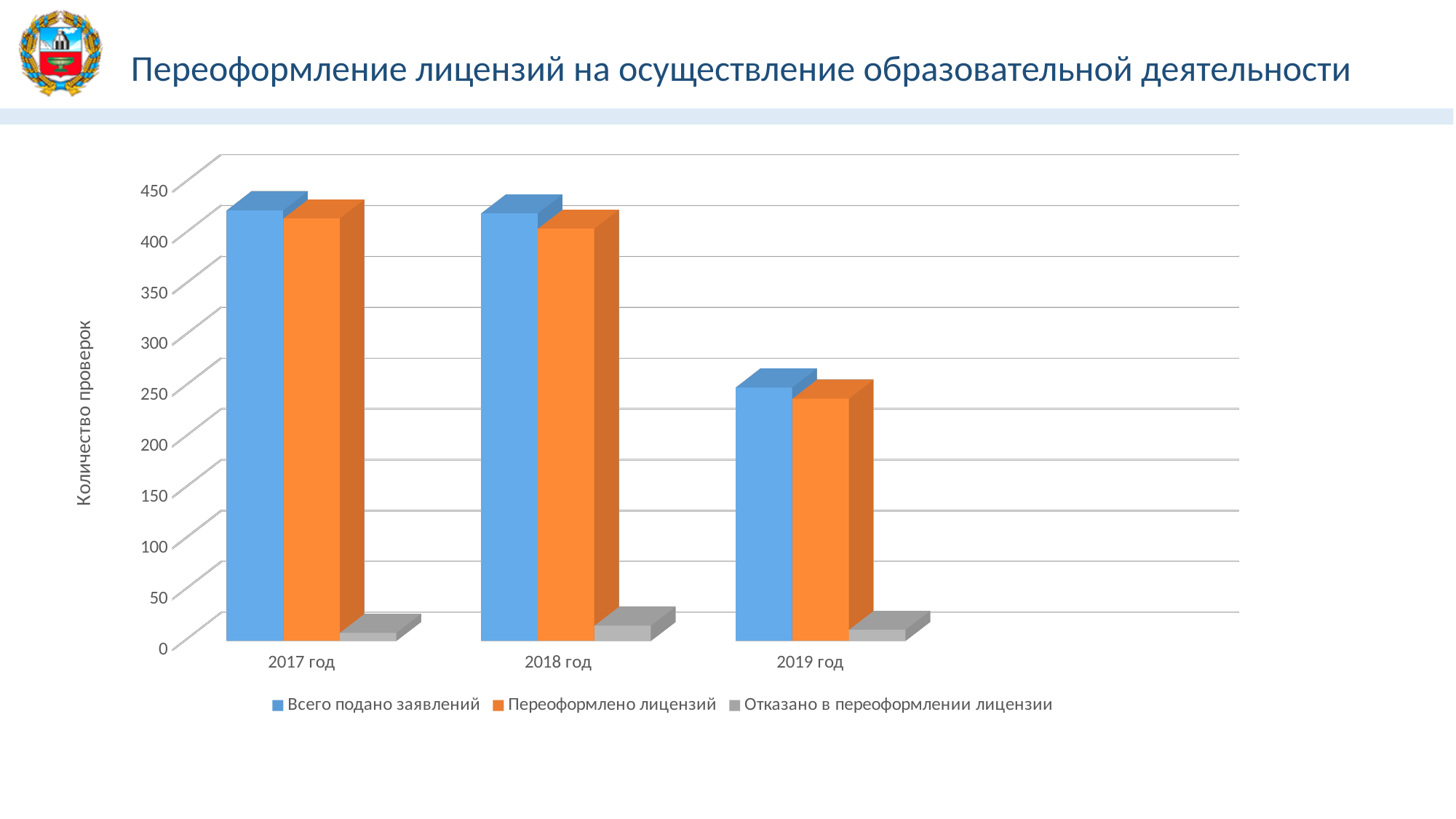
Is the value for Всего подано заявлений in 2019 год greater or less than 300? less Do the values for Всего подано заявлений rise or fall from 2017 год to 2019 год? fall Is the value for Переоформлено лицензий in 2019 год greater or less than 300? less What kind of chart is shown on the slide? bar chart How many series does the chart legend list? 3 Which is larger in 2019 год: Всего подано заявлений or Отказано в переоформлении лицензии? Всего подано заявлений Which year has the lowest value for Всего подано заявлений? 2019 год Is the value for Отказано в переоформлении лицензии in 2018 год greater or less than 50? less What is the label of the vertical axis of the chart? Количество проверок Which is larger for Всего подано заявлений: 2017 год or 2019 год? 2017 год How many years are shown on the x axis of the chart? 3